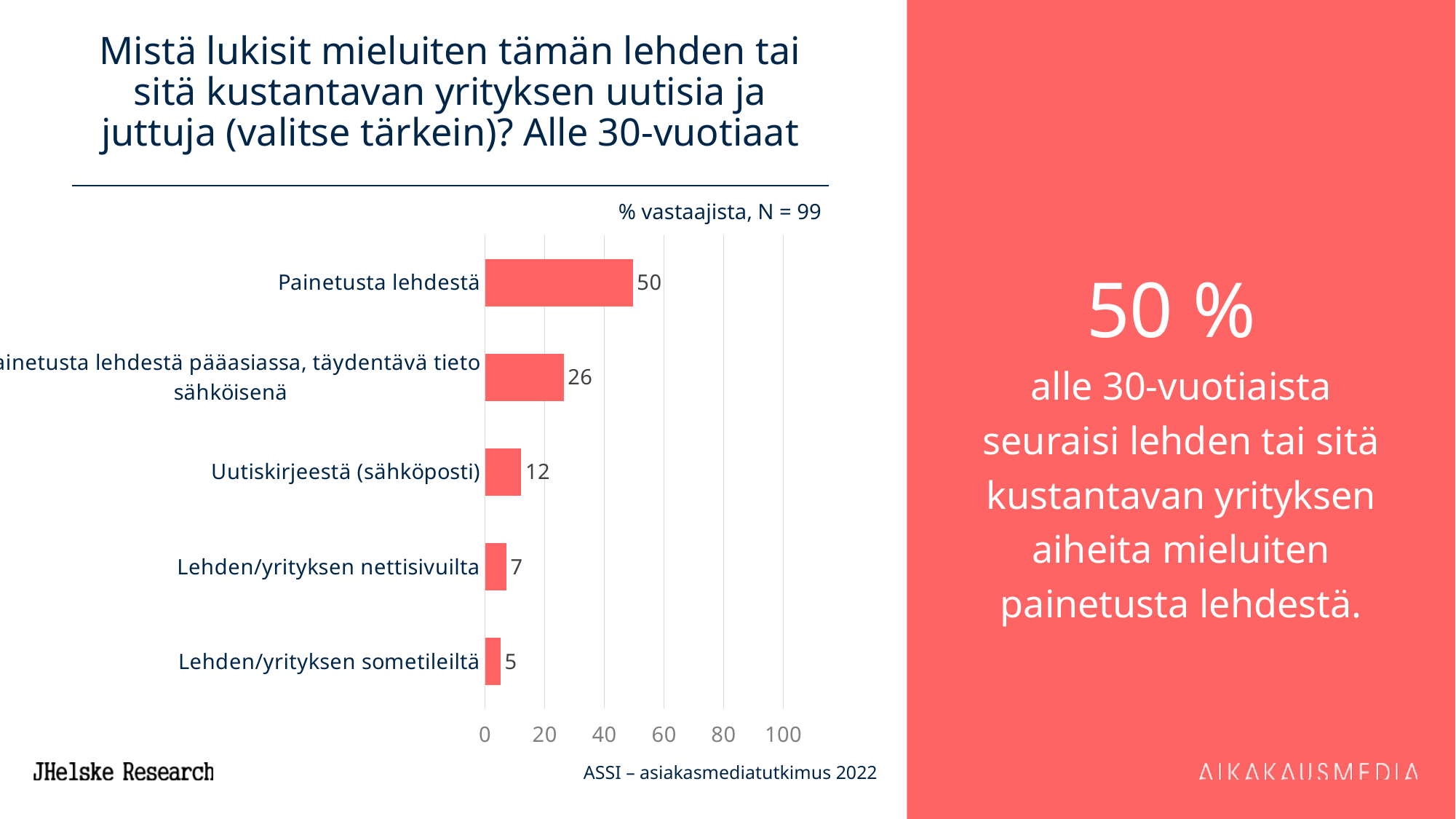
Which category has the lowest value? Lehden/yrityksen sometileiltä What is the value for Painetusta lehdestä? 50 Is the value for Painetusta lehdestä greater or less than 40? greater What is the value for Lehden/yrityksen nettisivuilta? 7 What is the value for Uutiskirjeestä (sähköposti)? 12 What is the difference between the values for Painetusta lehdestä and Uutiskirjeestä (sähköposti)? 38 How many categories are shown in the chart? 5 Which is larger, the value for Uutiskirjeestä (sähköposti) or the value for Lehden/yrityksen nettisivuilta? Uutiskirjeestä (sähköposti) What kind of chart is shown on the slide? bar chart Which category has the highest value? Painetusta lehdestä What is the value for Lehden/yrityksen sometileiltä? 5 What is the sample size (N) stated above the chart? 99